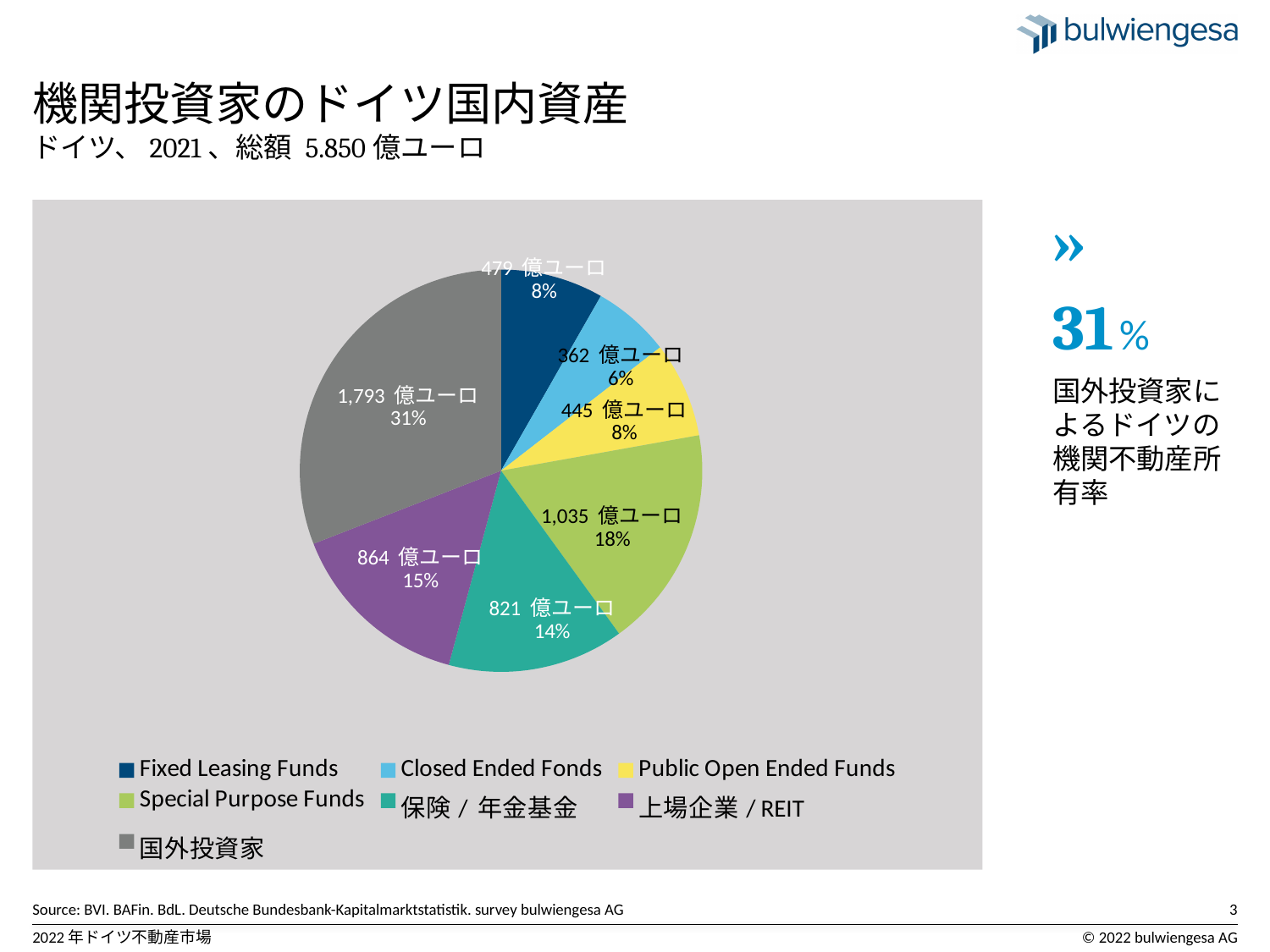
Which is larger, the value for 上場企業／REIT or the value for 保険／年金基金? 上場企業／REIT What share of the pie does 国外投資家 hold? 31% What value is shown for 上場企業／REIT in the pie chart? 864 億ユーロ What value is shown for 国外投資家 in the pie chart? 1,793 億ユーロ What kind of chart is shown on the slide? Pie chart What value is shown for Special Purpose Funds in the pie chart? 1,035 億ユーロ Which category has the largest slice in the pie chart? 国外投資家 What share of the pie does 保険／年金基金 hold? 14% What is the difference between the values for Fixed Leasing Funds and Public Open Ended Funds? 34 億ユーロ How many entries does the legend of the pie chart list? 7 Which category has the smallest slice in the pie chart? Closed Ended Fonds How many slices does the pie chart have? 7